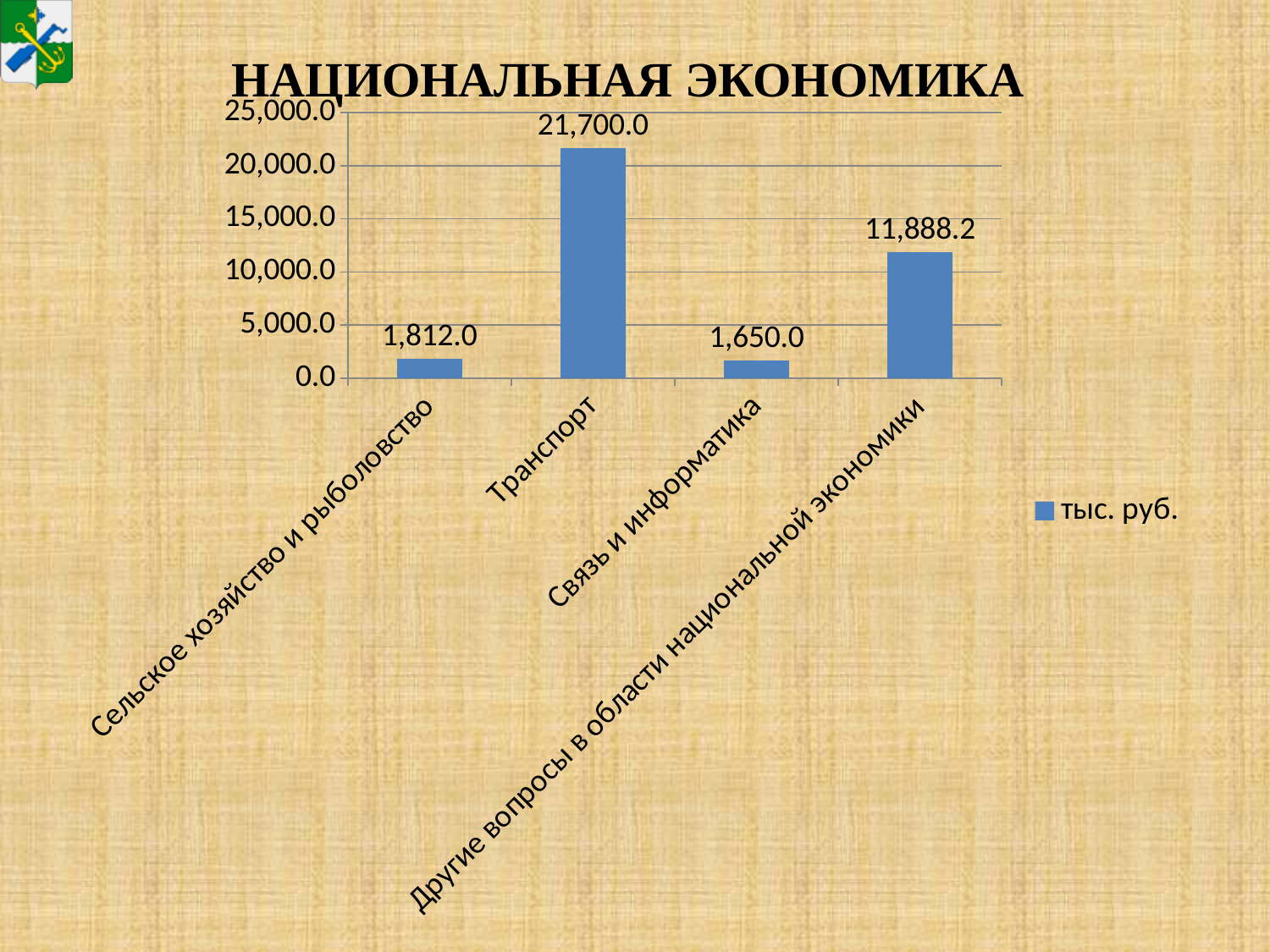
How many categories are shown on the chart? 4 What is the value for Сельское хозяйство и рыболовство? 1,812.0 What is the difference between the values for Транспорт and Другие вопросы в области национальной экономики? 9,811.8 What is the legend entry of the chart? тыс. руб. Which category has the lowest value? Связь и информатика Which category has the highest value? Транспорт What is the difference between the values for Сельское хозяйство и рыболовство and Связь и информатика? 162.0 What is the value for Другие вопросы в области национальной экономики? 11,888.2 Which is larger, the value for Сельское хозяйство и рыболовство or the value for Другие вопросы в области национальной экономики? Другие вопросы в области национальной экономики What is the value for Транспорт? 21,700.0 What is the value for Связь и информатика? 1,650.0 What kind of chart is shown on the slide? Bar chart